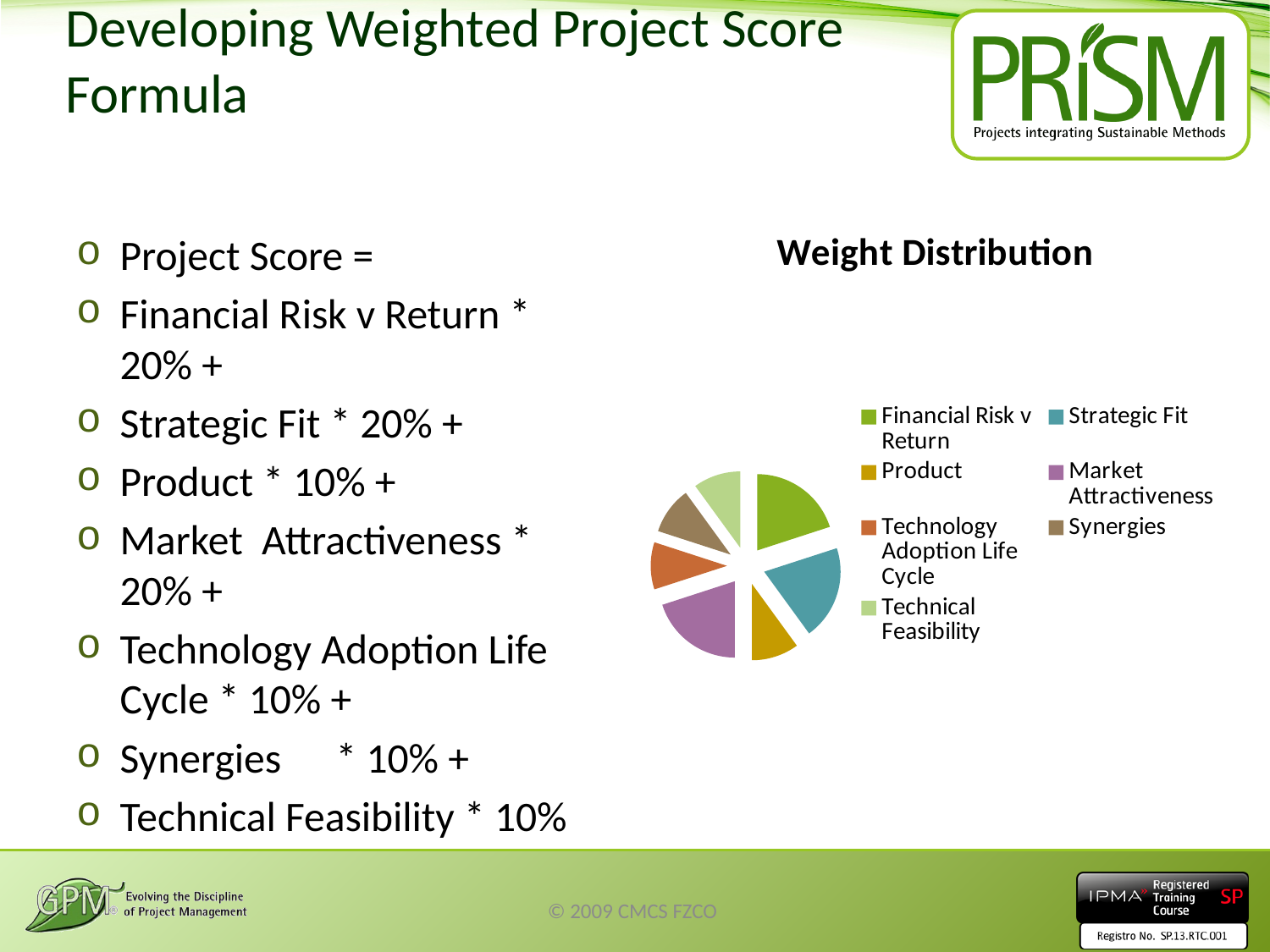
What is the title of the pie chart on the slide? Weight Distribution How many slices does the Weight Distribution pie chart have? 7 In the Weight Distribution pie chart, which slice is larger: Financial Risk v Return or Product? Financial Risk v Return In the Weight Distribution pie chart, which colour represents Financial Risk v Return? Green In the Weight Distribution pie chart, which slice is larger: Market Attractiveness or Technical Feasibility? Market Attractiveness What kind of chart is shown under the title "Weight Distribution"? Pie chart In the Weight Distribution pie chart, which slice is larger: Strategic Fit or Synergies? Strategic Fit How many entries does the legend of the Weight Distribution pie chart list? 7